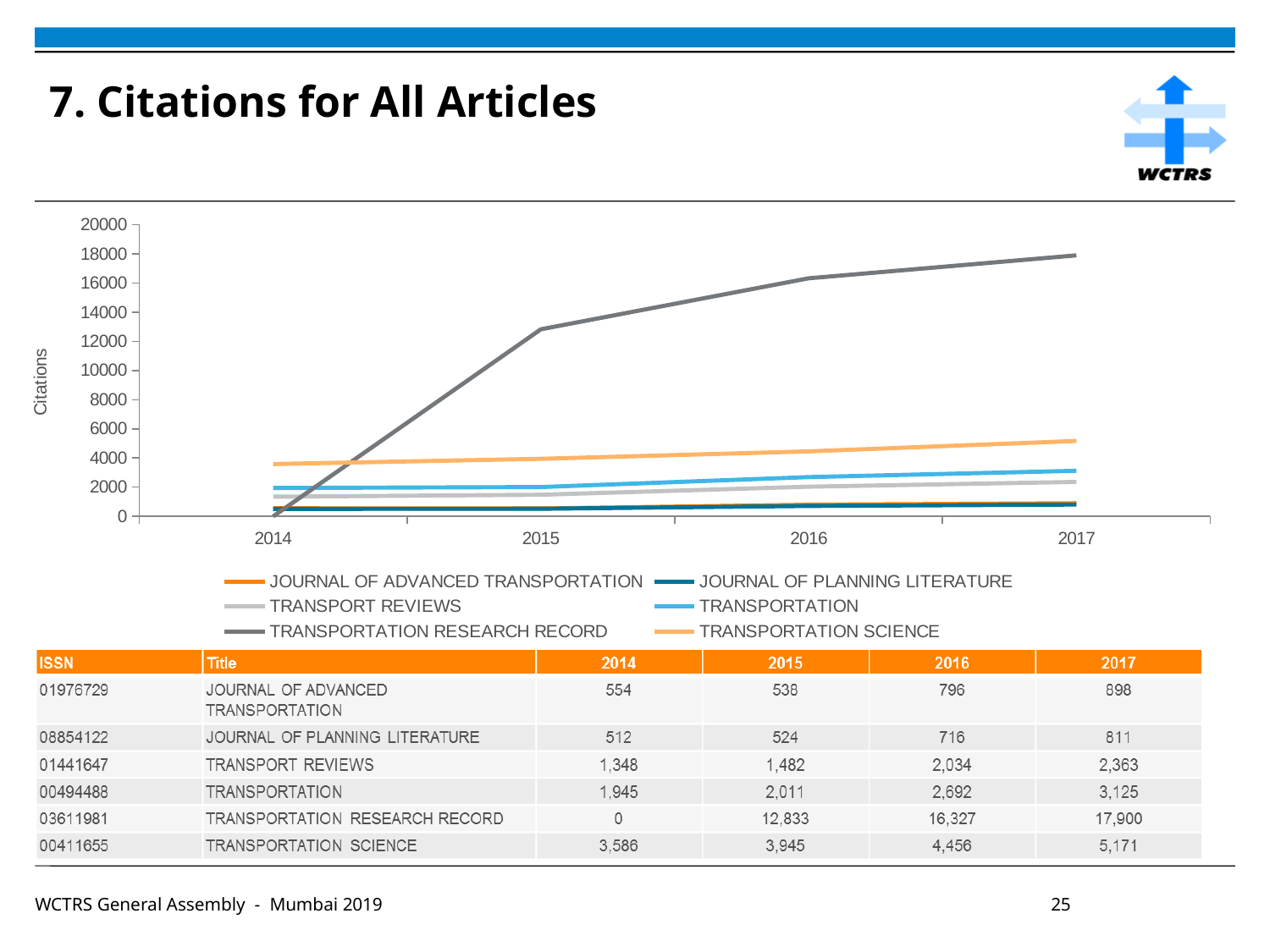
What type of chart is shown on the slide? line chart How many series does the legend list? 6 In 2016, which has more citations: TRANSPORT REVIEWS or TRANSPORTATION SCIENCE? TRANSPORTATION SCIENCE What is the 2014 value for TRANSPORTATION SCIENCE? 3,586 Which journal has the highest number of citations in 2017? TRANSPORTATION RESEARCH RECORD Which journal has the lowest number of citations in 2016? JOURNAL OF PLANNING LITERATURE How many citations did TRANSPORTATION RESEARCH RECORD have in 2017? 17,900 Is the value for TRANSPORTATION RESEARCH RECORD in 2015 greater or less than 12000? greater By how much did citations for TRANSPORTATION increase from 2014 to 2017? 1,180 How many years are plotted along the x axis? 4 Do the citations for TRANSPORTATION SCIENCE rise or fall from 2014 to 2017? rise What is the difference between the 2016 and 2015 values for TRANSPORTATION RESEARCH RECORD? 3,494